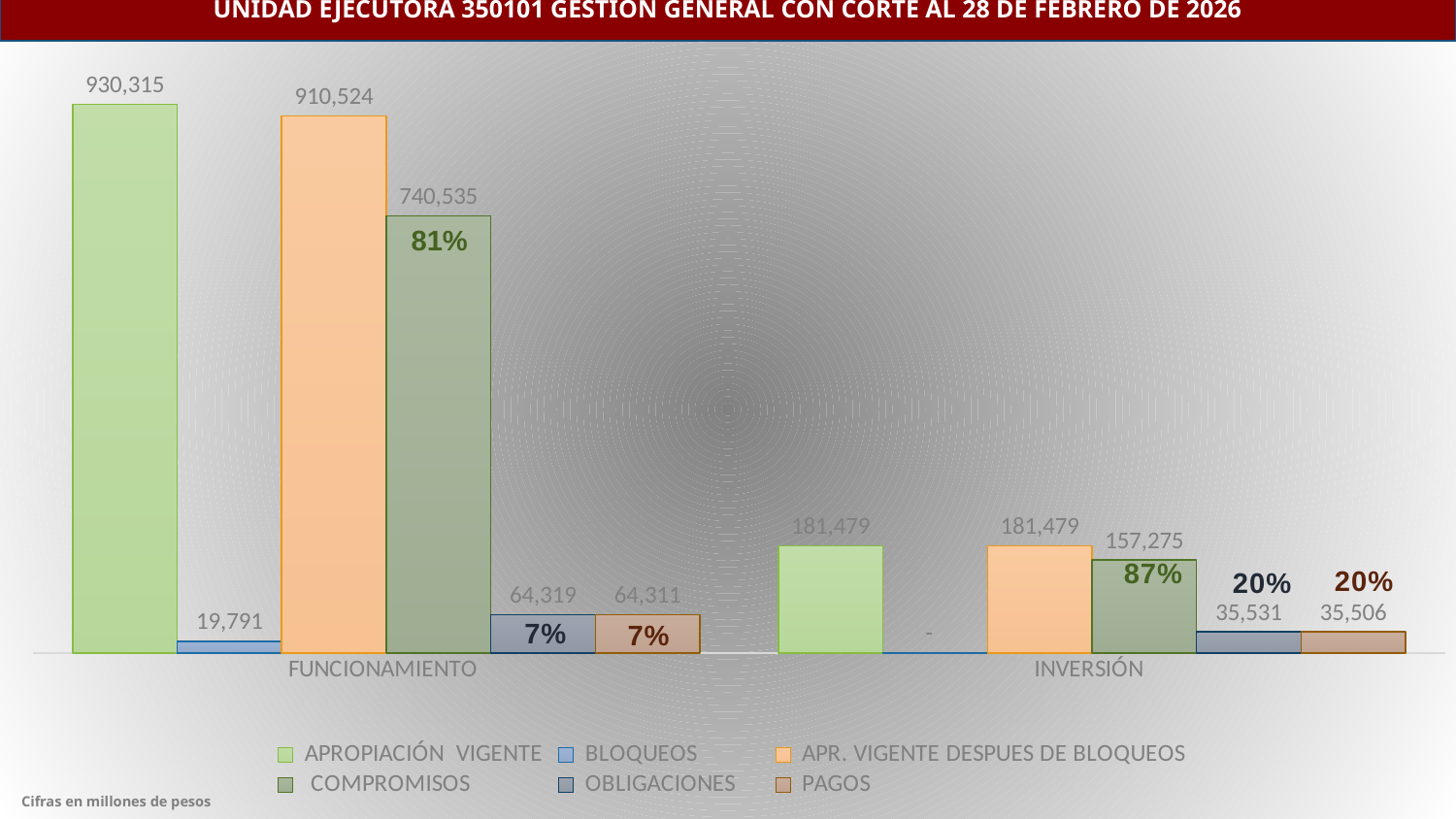
What is the value of COMPROMISOS for INVERSIÓN? 157,275 What is the value of BLOQUEOS for FUNCIONAMIENTO? 19,791 What type of chart is shown on the slide? Bar chart Which is larger: COMPROMISOS for FUNCIONAMIENTO or COMPROMISOS for INVERSIÓN? COMPROMISOS for FUNCIONAMIENTO What percentage is shown on the COMPROMISOS bar for FUNCIONAMIENTO? 81% What is the value of APROPIACIÓN VIGENTE for FUNCIONAMIENTO? 930,315 What is the difference between APR. VIGENTE DESPUES DE BLOQUEOS and COMPROMISOS for INVERSIÓN? 24,204 What percentage is shown on the OBLIGACIONES bar for INVERSIÓN? 20% How many series does the legend list? 6 Which series has the highest value for FUNCIONAMIENTO? APROPIACIÓN VIGENTE How many categories are shown on the x axis? 2 Which series has the lowest value for FUNCIONAMIENTO? BLOQUEOS